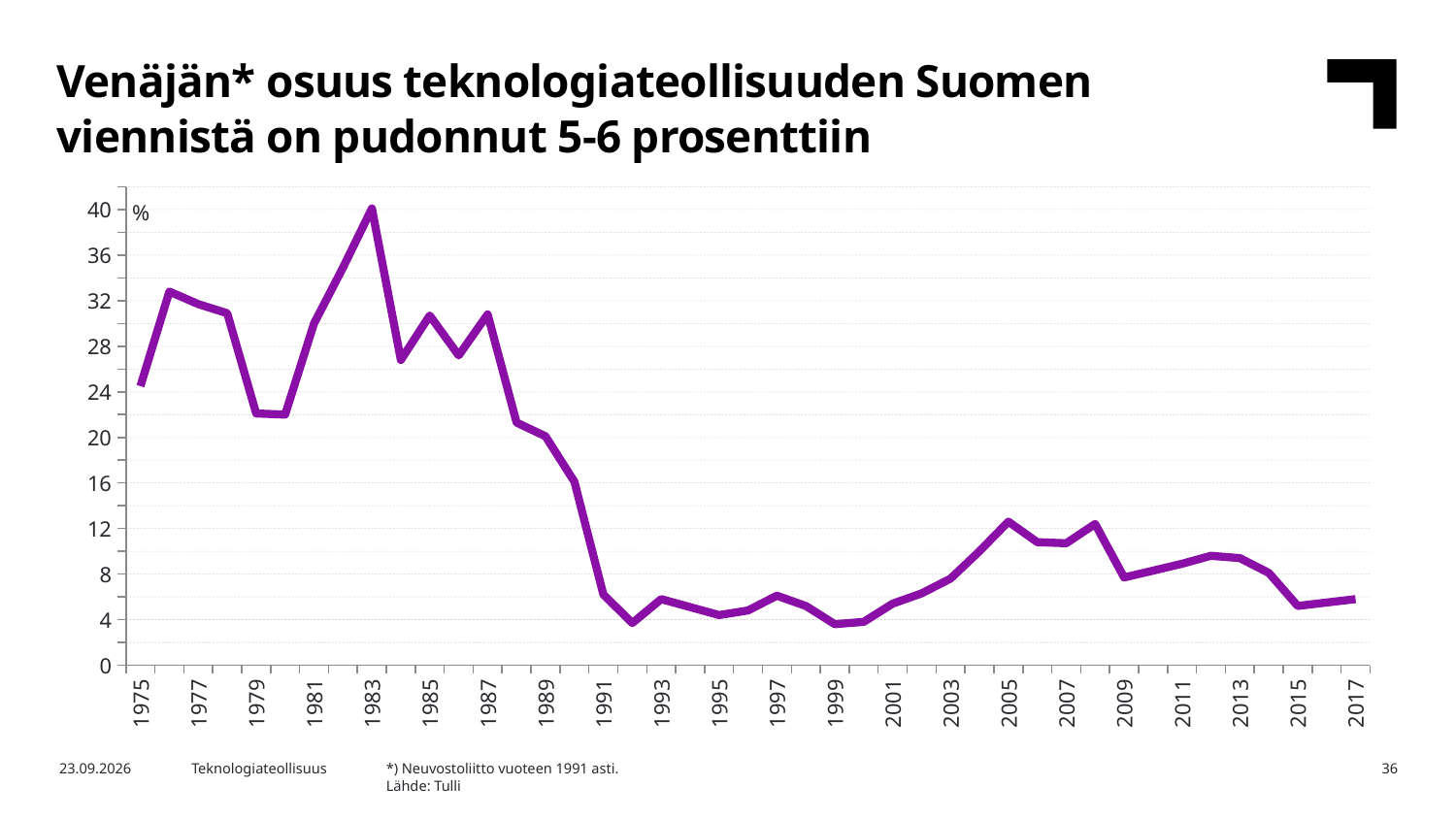
Is the value for 1991 greater or less than 8? less Is the value for 1975 greater or less than 20? greater Which year has the larger value, 1983 or 1985? 1983 Is the value for 1983 greater or less than 36? greater In which year does the line reach its highest value? 1983 What kind of chart is shown on the slide? line chart Which year has the larger value, 2005 or 2015? 2005 Overall, do the values rise or fall from 1975 to 2017? fall What is the last year labelled on the x axis? 2017 What unit is shown on the y axis of the chart? %